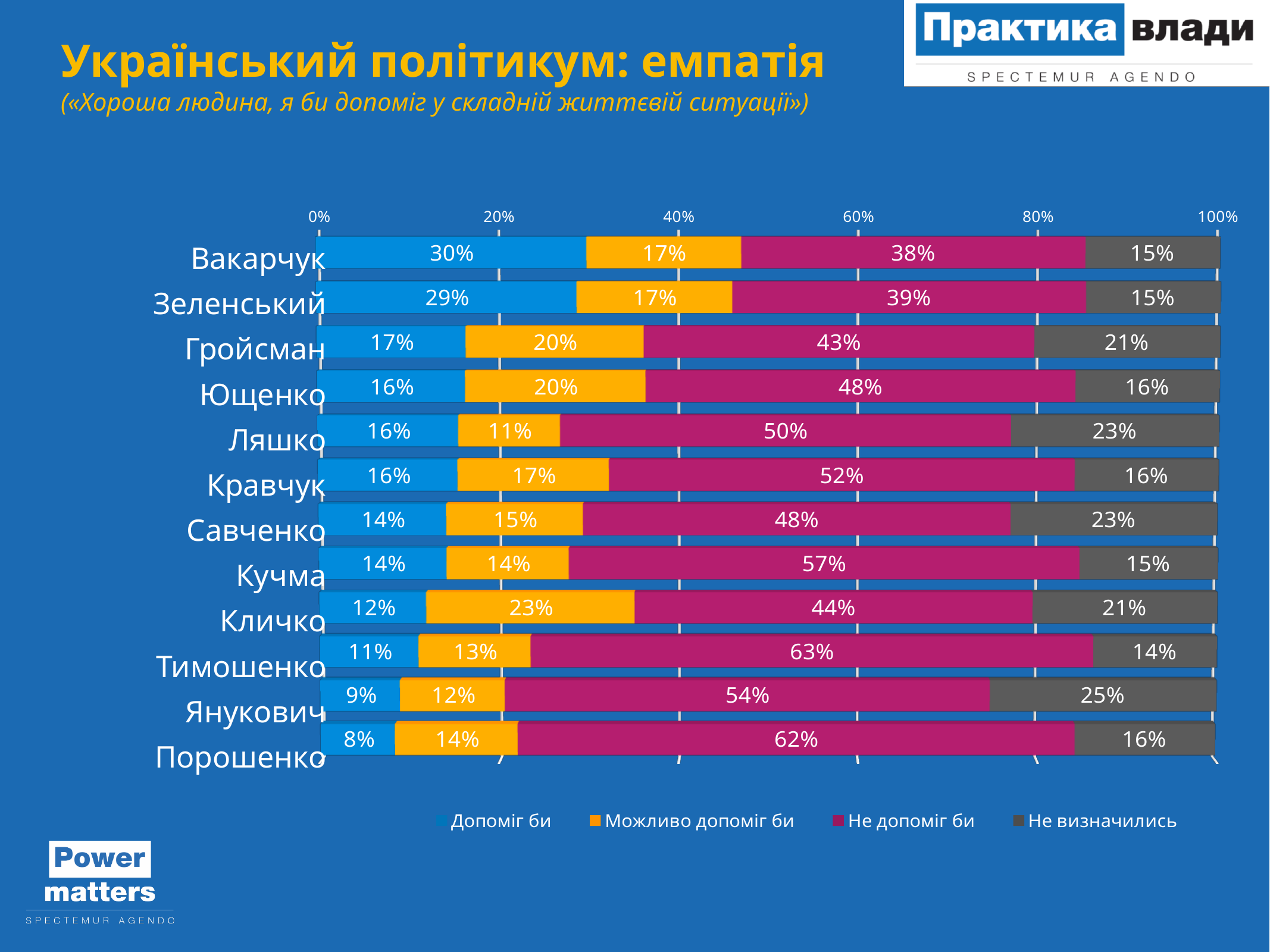
What is the "Не визначились" value for Янукович? 25% Which politician has the lowest "Допоміг би" value? Порошенко Which is larger: the "Не визначились" value for Ляшко or for Кучма? Ляшко What is the "Допоміг би" value for Вакарчук? 30% What is the "Не допоміг би" value for Тимошенко? 63% How many series does the legend list? 4 What is the "Можливо допоміг би" value for Кличко? 23% Which politician has the highest "Не допоміг би" value? Тимошенко What is the difference between the "Не допоміг би" values for Кучма and Вакарчук? 19% How many politicians are shown in the chart? 12 Which politician has the highest "Допоміг би" value? Вакарчук What kind of chart is shown on the slide? Stacked bar chart